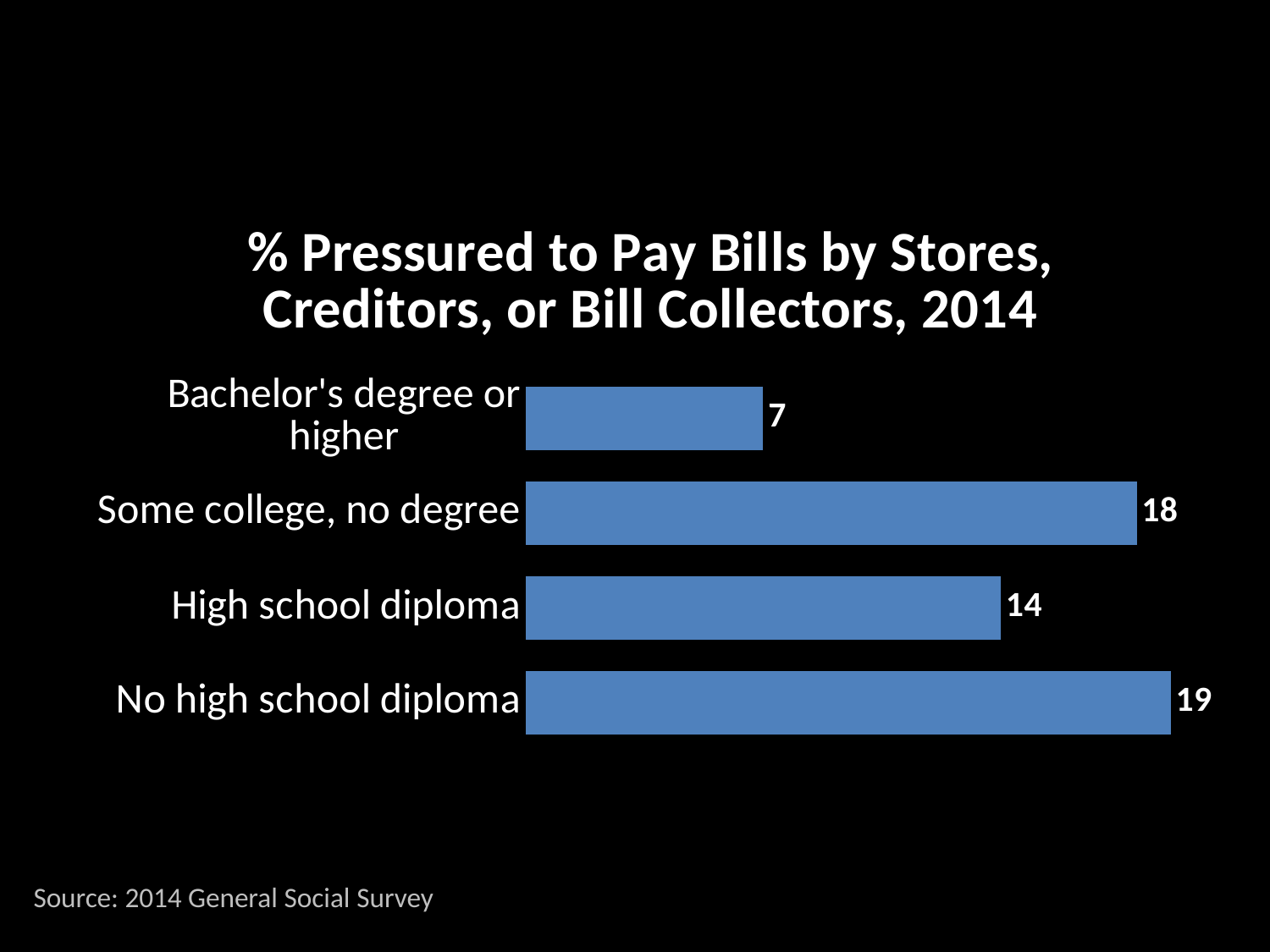
How many categories are shown in the chart? 4 What is the difference between the values for 'Some college, no degree' and 'High school diploma'? 4 What is the value for 'No high school diploma'? 19 What is the title of the chart? % Pressured to Pay Bills by Stores, Creditors, or Bill Collectors, 2014 Which category has the lowest value? Bachelor's degree or higher Which is larger, the value for 'High school diploma' or the value for 'Some college, no degree'? Some college, no degree What is the difference between the values for 'No high school diploma' and 'Bachelor's degree or higher'? 12 Which category has the highest value? No high school diploma What is the value for 'High school diploma'? 14 What is the value for 'Some college, no degree'? 18 What is the value for 'Bachelor's degree or higher'? 7 What kind of chart is shown on the slide? Bar chart